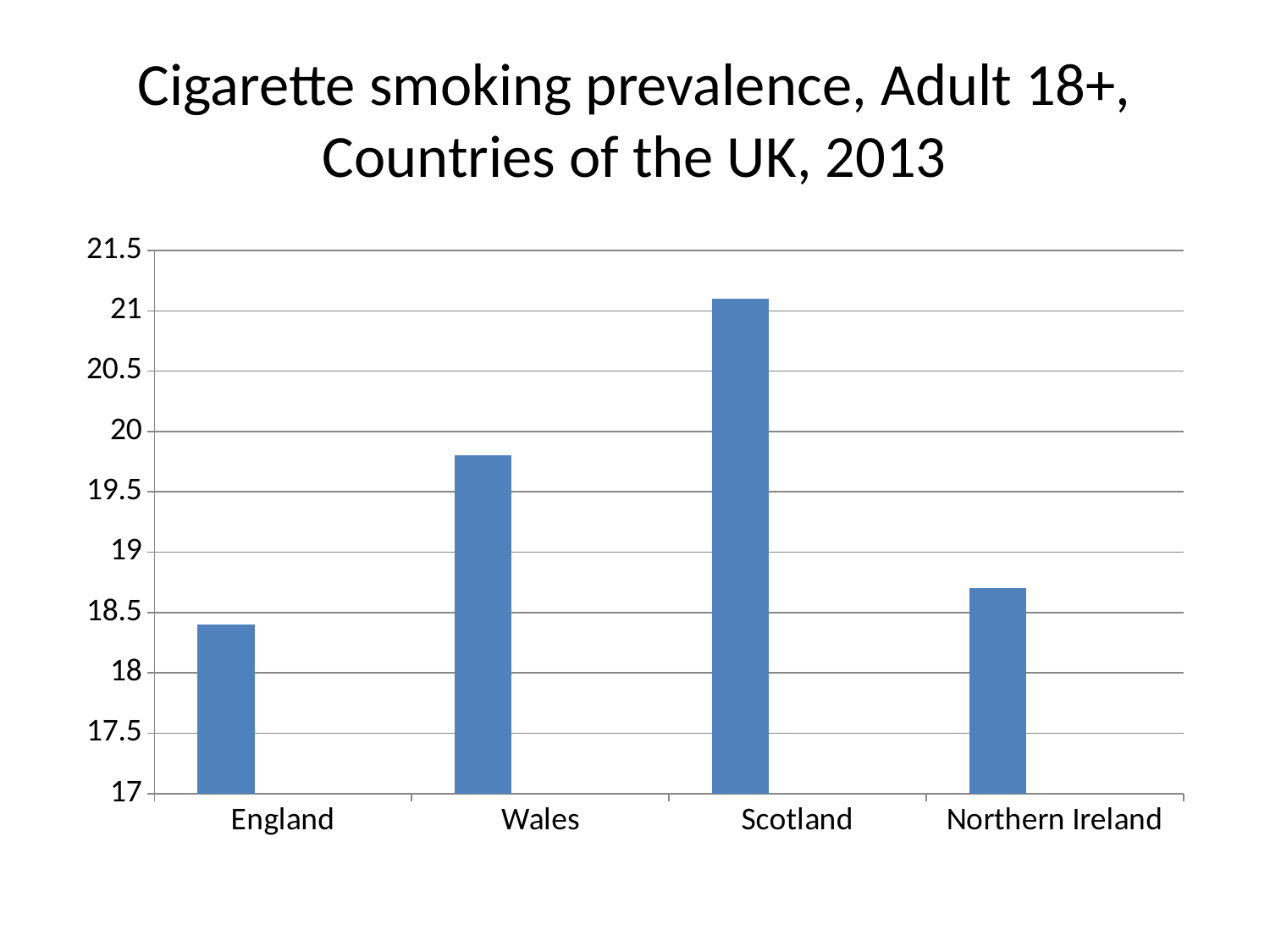
Which country has the lowest cigarette smoking prevalence in the chart? England Is the value for England greater or less than 19? less Is the value for Wales greater or less than 19.5? greater Is the value for Scotland greater or less than 21? greater Which has the larger value, England or Scotland? Scotland What kind of chart is shown on the slide? bar chart What year does the chart title say the data is for? 2013 Which has the larger value, Wales or Northern Ireland? Wales Which country has the highest cigarette smoking prevalence in the chart? Scotland How many countries are shown on the x axis of the chart? 4